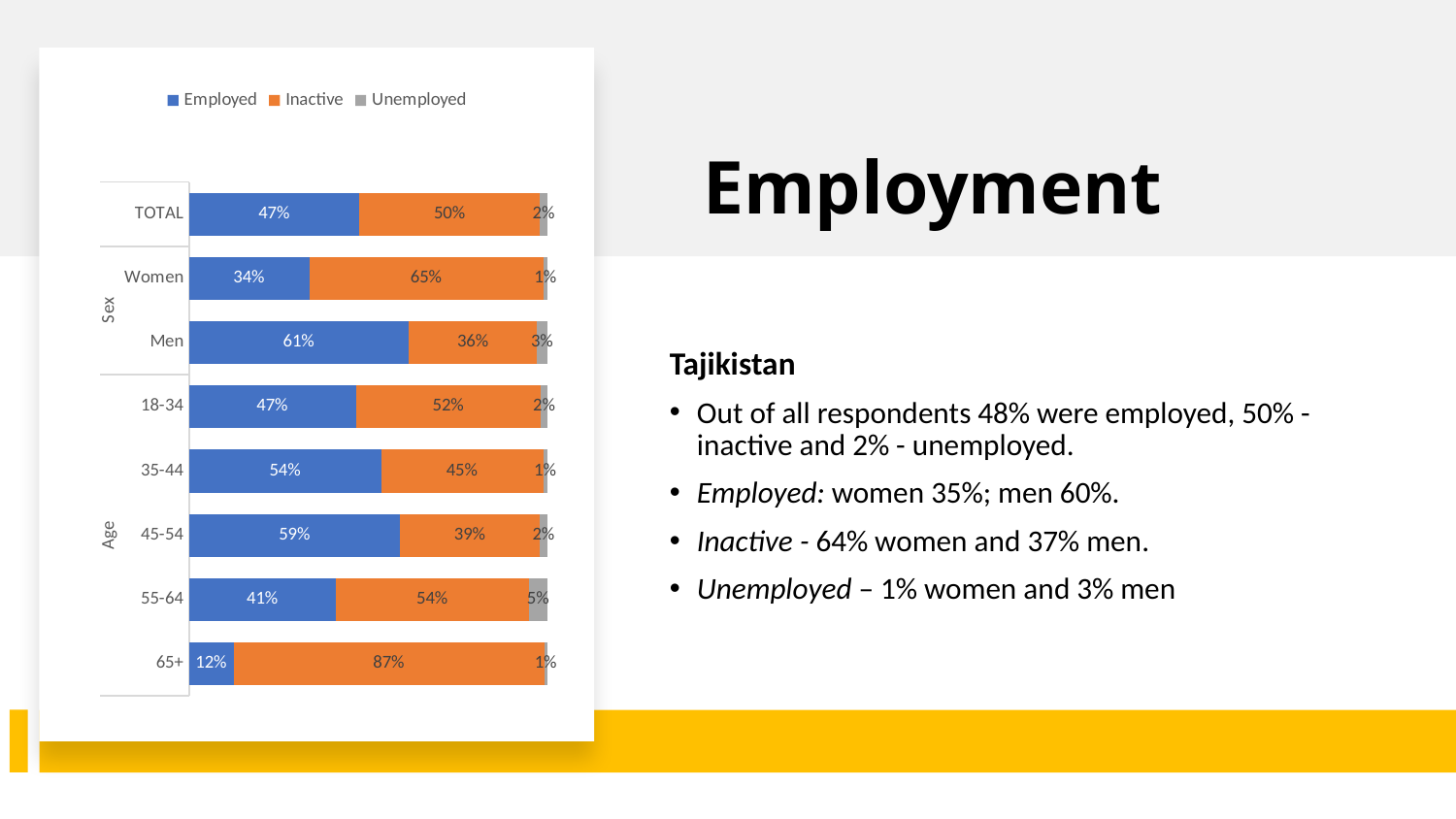
How many categories are plotted on the chart? 8 Which series is shown in orange in the chart legend? Inactive How many series does the chart legend list? 3 What kind of chart is shown on the slide? Stacked bar chart Which is larger, the Inactive value for Women or the Inactive value for Men? Women What is the Unemployed value for the 55-64 age group? 5% What is the Employed value for the TOTAL category? 47% What is the Inactive value for the 65+ age group? 87% Which category has the highest Employed value? Men What is the difference between the Employed values for Men and Women? 27% Which category has the lowest Employed value? 65+ What is the Employed value for Men? 61%